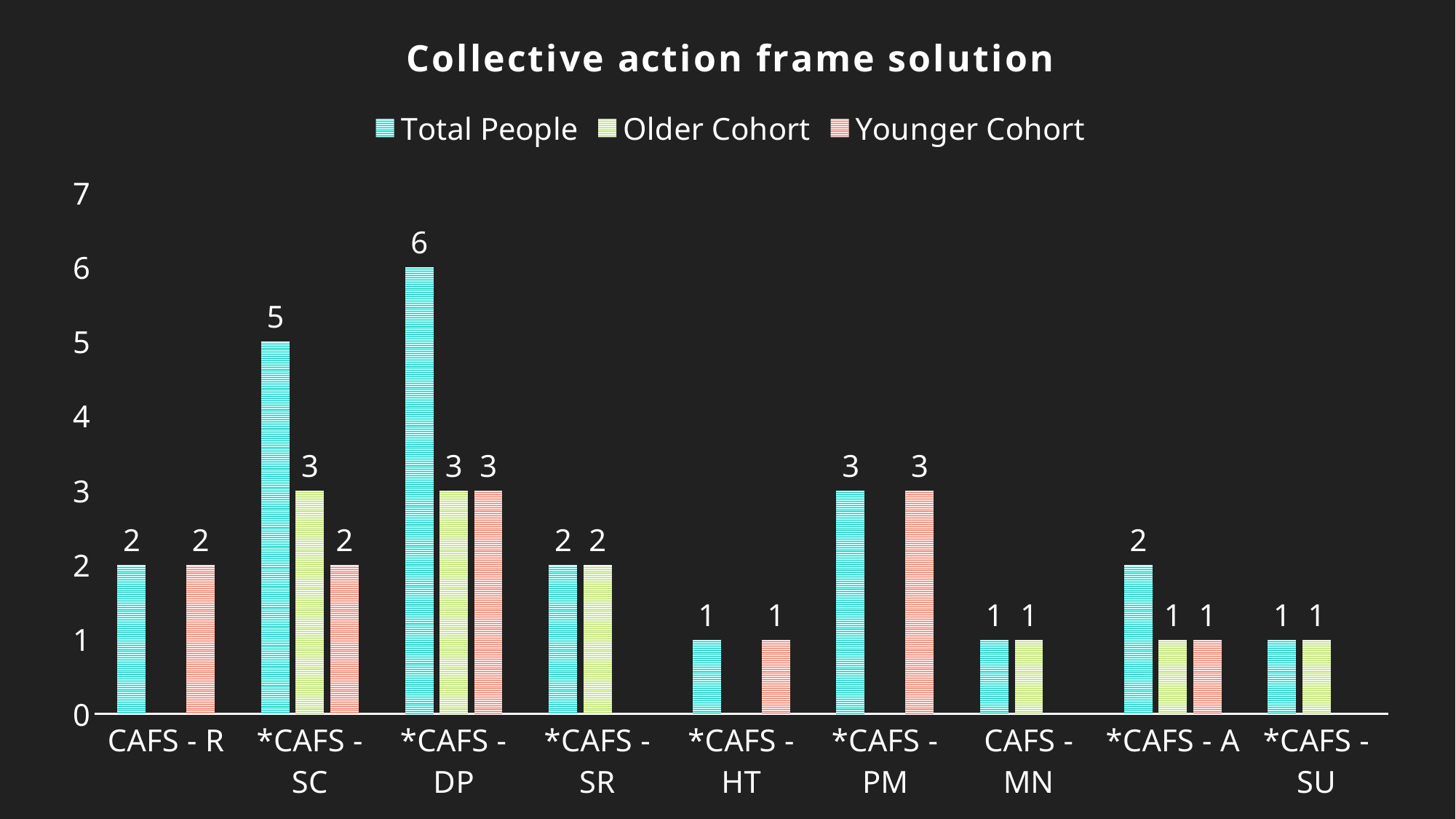
What is the Younger Cohort value for *CAFS - PM? 3 Which is larger, the Total People value for *CAFS - SC or for *CAFS - PM? *CAFS - SC What is the Older Cohort value for *CAFS - SC? 3 What is the title of the chart? Collective action frame solution Which category has the highest Total People value? *CAFS - DP What is the difference between the Total People values for *CAFS - DP and *CAFS - SC? 1 What is the Younger Cohort value for CAFS - R? 2 What kind of chart is shown on the slide? Bar chart What is the difference between the Older Cohort and Younger Cohort values for *CAFS - SC? 1 How many series does the legend list? 3 How many categories are shown on the x axis? 9 What is the Total People value for *CAFS - DP? 6